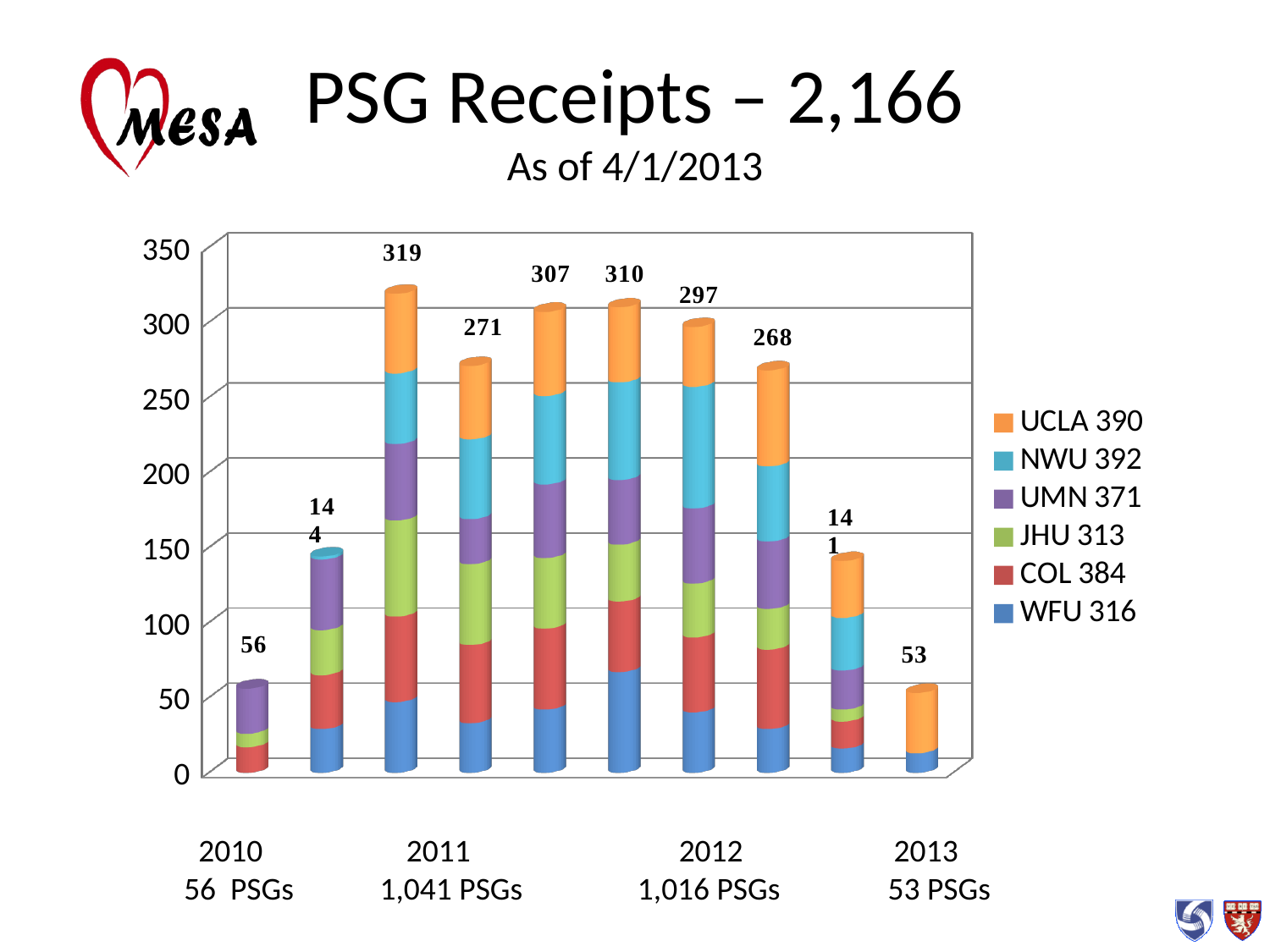
What is the total of the tallest bar in the chart? 319 What is the total of the single bar for 2013? 53 According to the legend, which site has the highest number of PSGs? NWU 392 What is the difference between the tallest bar (319) and the shortest bar (53)? 266 Which is larger, the 2010 bar or the 2013 bar? 2010 How many bars are plotted in the chart? 10 How many PSGs are shown for 2011 in the axis label below the chart? 1,041 PSGs What is the total of the single bar for 2010? 56 What is the total of the shortest bar in the chart? 53 How many bars have a total greater than 300? 3 How many series does the legend list? 6 What kind of chart is shown on the slide? stacked bar chart